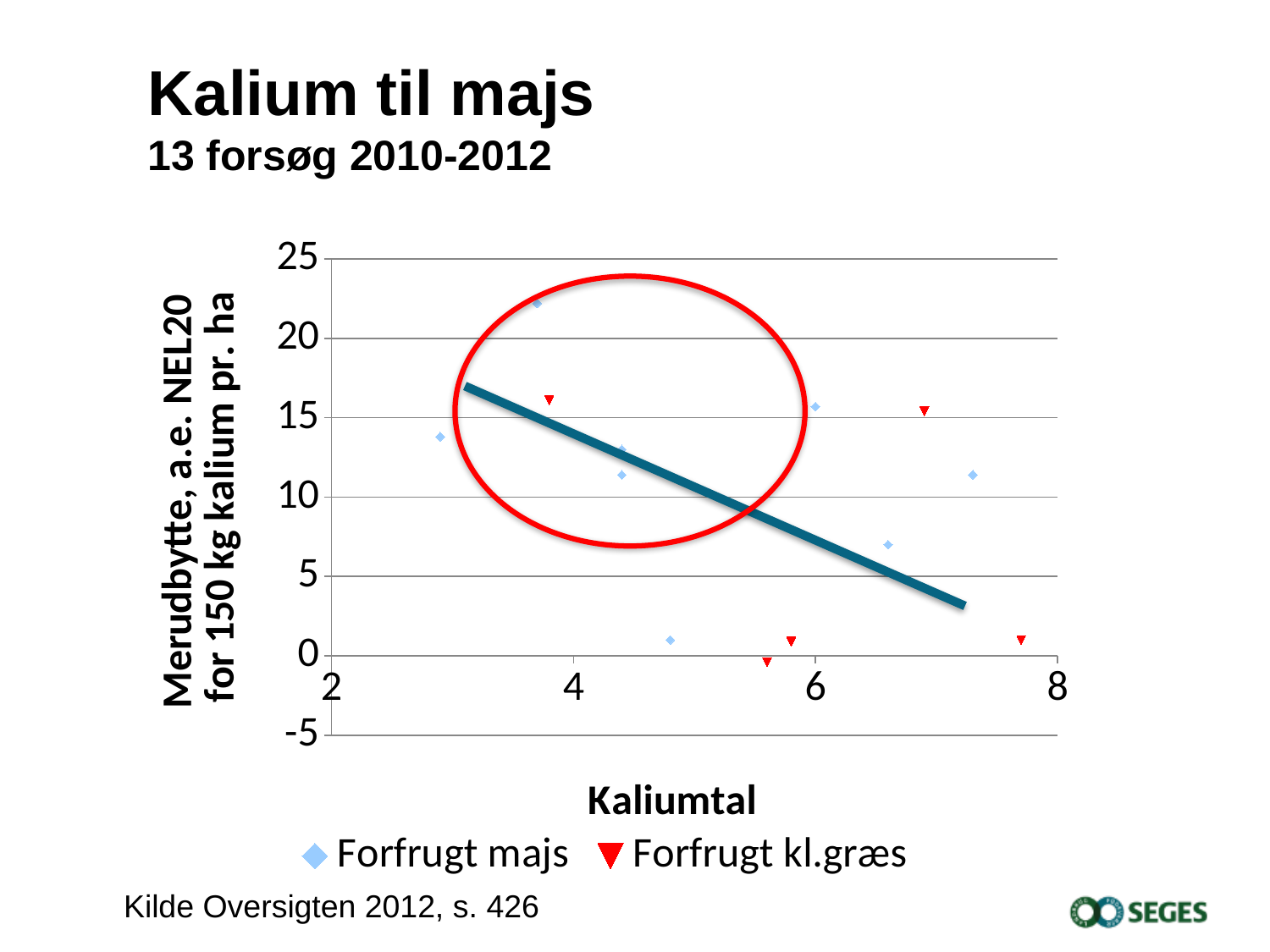
Does the trend line rise or fall as Kaliumtal increases? fall What are the two series named in the legend? Forfrugt majs and Forfrugt kl.græs Is the highest Forfrugt kl.græs point greater or less than 20? less What kind of chart is shown on the slide? scatter chart How many data points are plotted in total on the chart? 13 Is the value of the trend line at Kaliumtal 7 greater or less than 5? less What is the title of the x axis? Kaliumtal Which series contains the highest plotted point? Forfrugt majs Is the highest Forfrugt majs point greater or less than 20? greater How many Forfrugt majs points are plotted? 8 How many Forfrugt kl.græs points are plotted? 5 How many series does the legend list? 2